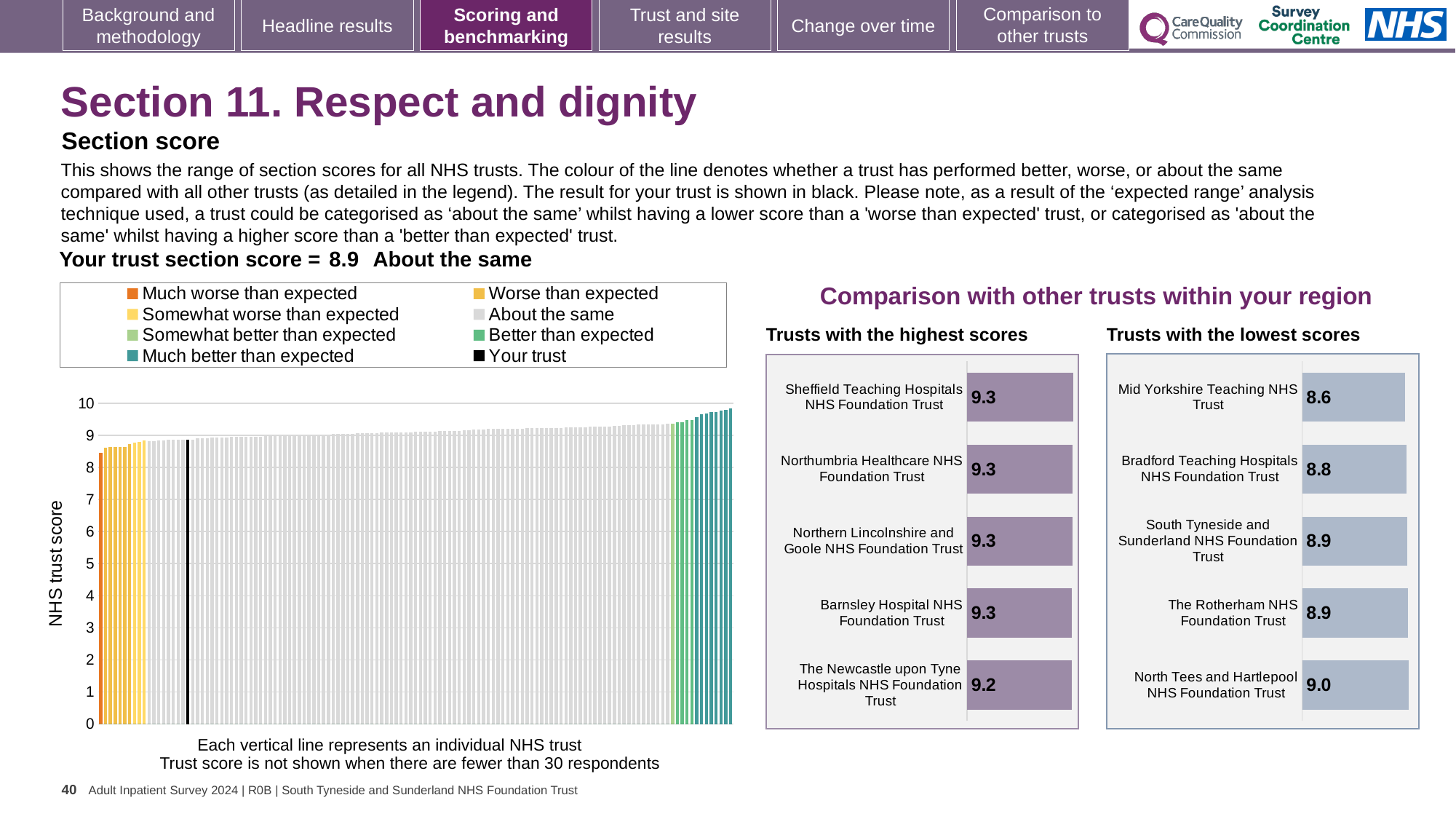
In the 'Trusts with the highest scores' chart, which trust has the lowest score? The Newcastle upon Tyne Hospitals NHS Foundation Trust How many entries does the legend of the large chart on the left list? 8 In the 'Trusts with the lowest scores' chart, what is the difference between the scores of North Tees and Hartlepool NHS Foundation Trust and Mid Yorkshire Teaching NHS Trust? 0.4 In the 'Trusts with the lowest scores' chart, which has the higher score: Bradford Teaching Hospitals NHS Foundation Trust or Mid Yorkshire Teaching NHS Trust? Bradford Teaching Hospitals NHS Foundation Trust In the large chart on the left, do the trust scores rise or fall from left to right? Rise What type of chart is the large chart on the left showing NHS trust scores? Bar chart In the 'Trusts with the lowest scores' chart, what is the score for Mid Yorkshire Teaching NHS Trust? 8.6 In the 'Trusts with the highest scores' chart, what is the difference between the scores of Sheffield Teaching Hospitals NHS Foundation Trust and The Newcastle upon Tyne Hospitals NHS Foundation Trust? 0.1 In the 'Trusts with the highest scores' chart, what is the score for The Newcastle upon Tyne Hospitals NHS Foundation Trust? 9.2 In the 'Trusts with the lowest scores' chart, which trust has the lowest score? Mid Yorkshire Teaching NHS Trust In the 'Trusts with the lowest scores' chart, which trust has the highest score? North Tees and Hartlepool NHS Foundation Trust In the 'Trusts with the highest scores' chart, how many trusts are shown? 5